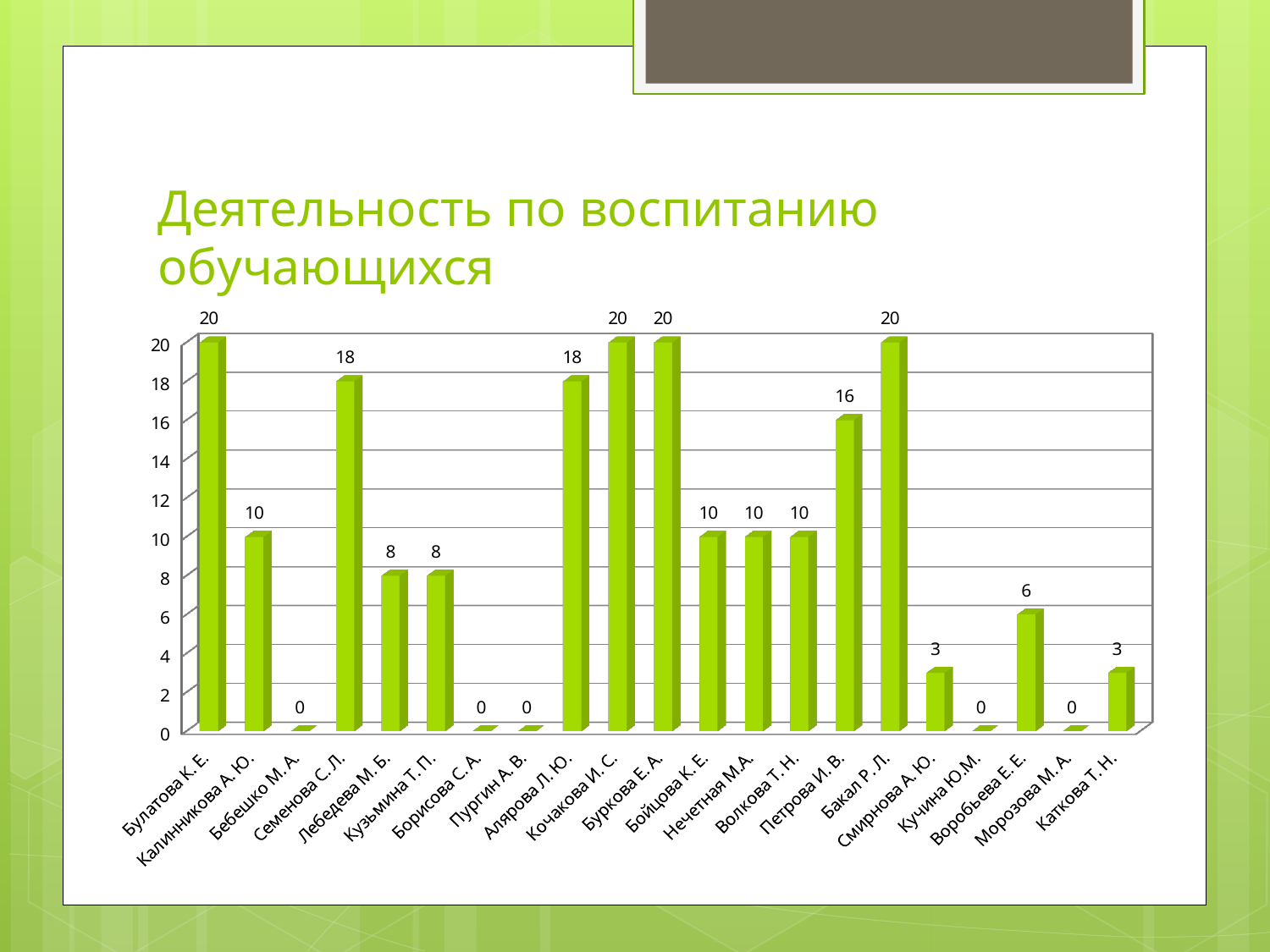
What is the value for Семенова С. Л.? 18 What is the value for Кучина Ю.М.? 0 What is the value for Воробьева Е. Е.? 6 How many categories are shown on the x axis? 21 What is the value for Петрова И. В.? 16 What is the difference between the values for Булатова К. Е. and Калинникова А. Ю.? 10 What kind of chart is shown on the slide? Bar chart What is the title of the slide? Деятельность по воспитанию обучающихся Which has a larger value, Лебедева М. Б. or Бойцова К. Е.? Бойцова К. Е. What is the highest value shown on the chart? 20 What is the value for Смирнова А. Ю.? 3 What is the difference between the values for Петрова И. В. and Воробьева Е. Е.? 10